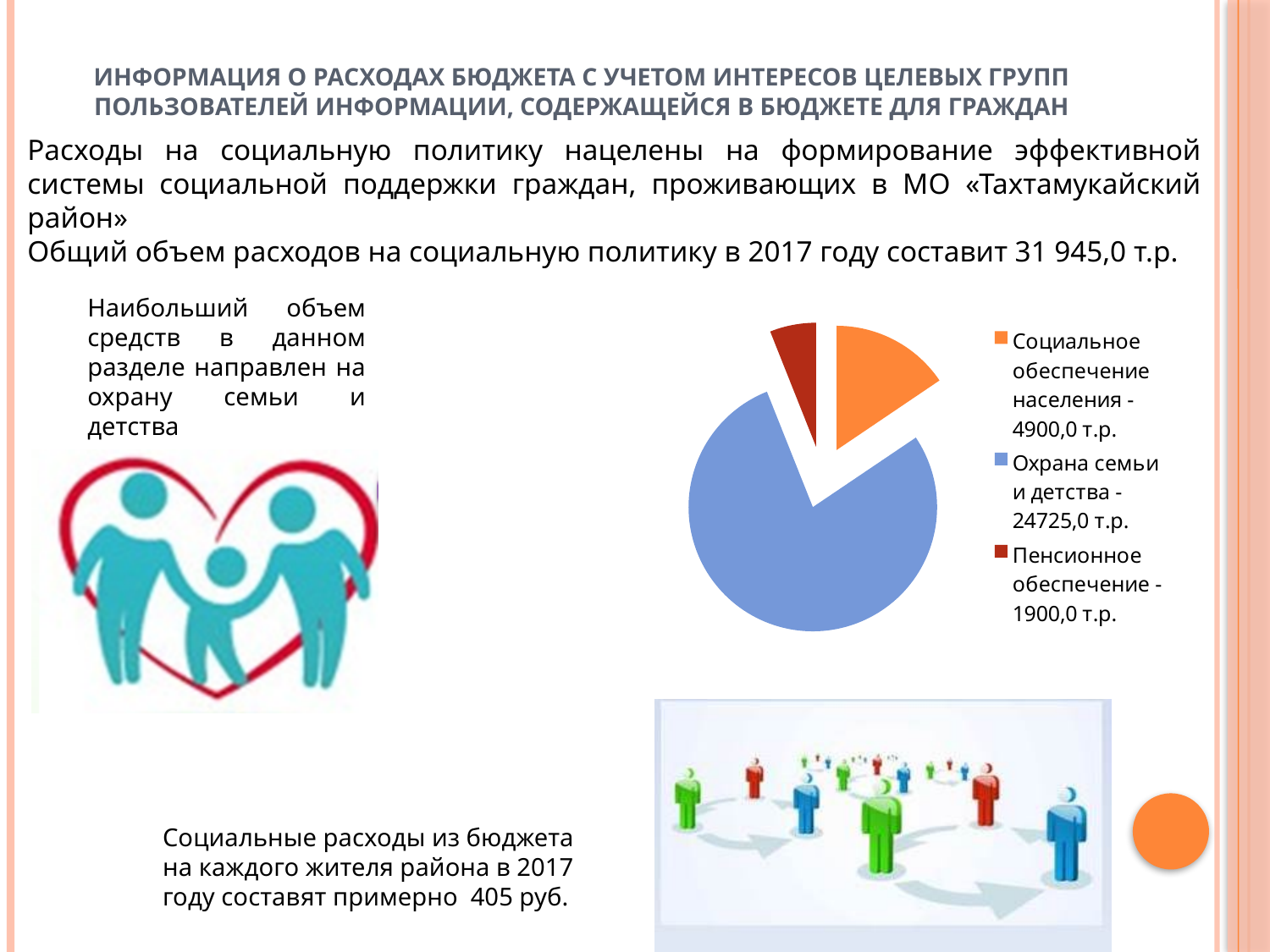
На сколько объём средств на охрану семьи и детства больше объёма на социальное обеспечение населения? 19825,0 т.р. Что больше: объём средств на социальное обеспечение населения или на пенсионное обеспечение? Социальное обеспечение населения Какая категория на диаграмме имеет наибольший объём средств? Охрана семьи и детства Сколько категорий показано на круговой диаграмме? 3 Какой объём средств направлен на социальное обеспечение населения согласно диаграмме? 4900,0 т.р. Какой объём средств направлен на пенсионное обеспечение согласно диаграмме? 1900,0 т.р. Какой объём средств направлен на охрану семьи и детства согласно диаграмме? 24725,0 т.р. Какой тип диаграммы показан на слайде? Круговая диаграмма Какая категория на диаграмме имеет наименьший объём средств? Пенсионное обеспечение Каким цветом на диаграмме обозначена категория «Пенсионное обеспечение»? Тёмно-красным На сколько объём средств на социальное обеспечение населения больше объёма на пенсионное обеспечение? 3000,0 т.р. Каким цветом на диаграмме обозначена категория «Охрана семьи и детства»? Синим